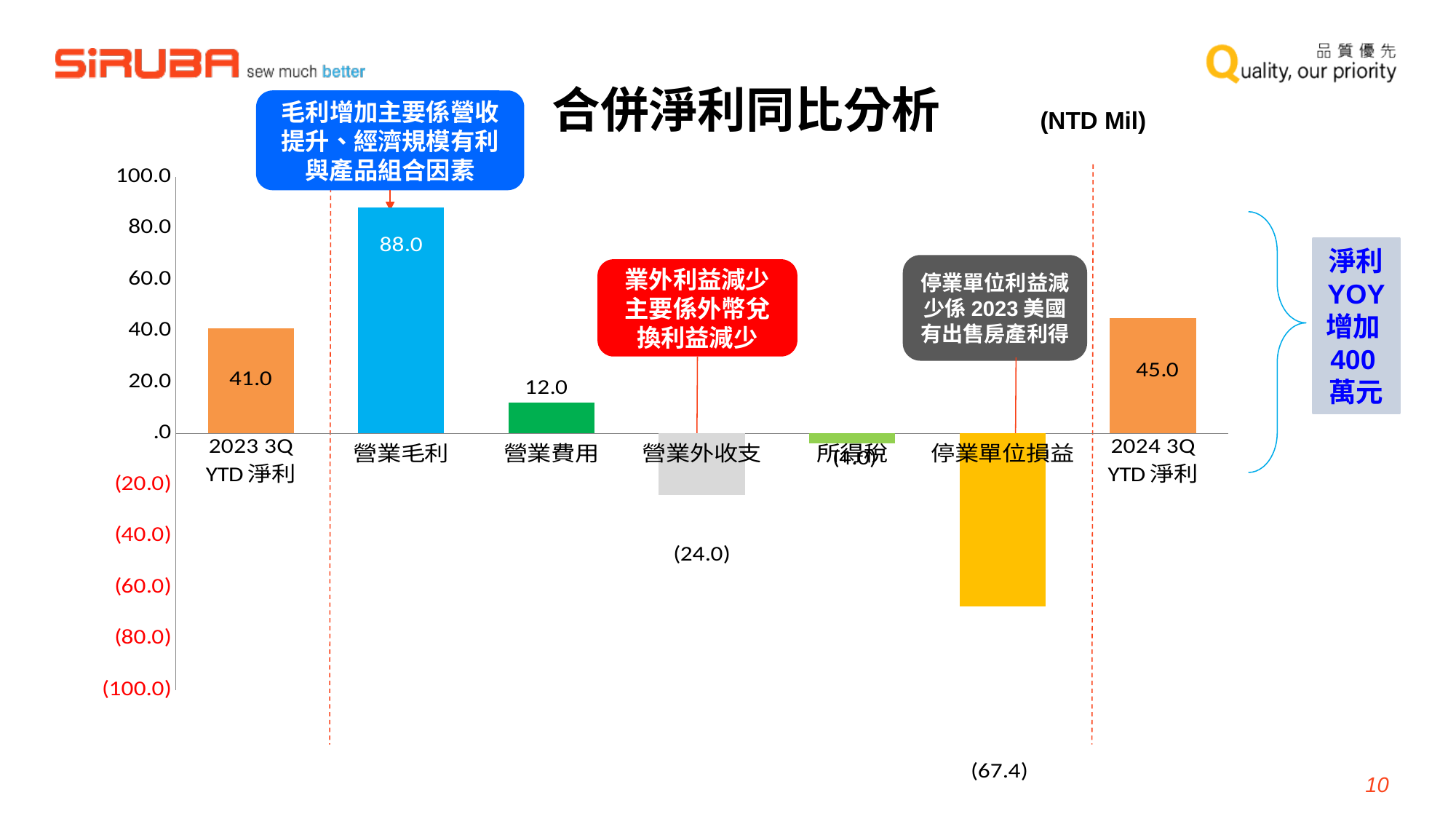
What is the value for 2023 3Q YTD 淨利? 41.0 What is the value for 停業單位損益? (67.4) Which category has the highest value? 營業毛利 What kind of chart is shown on the slide? Bar chart Which category has the lowest value? 停業單位損益 What is the value for 營業毛利? 88.0 What is the difference between the 2024 3Q YTD 淨利 and 2023 3Q YTD 淨利 values? 4.0 How many categories are shown on the x axis? 7 What is the value for 營業外收支? (24.0) What is the value for 營業費用? 12.0 What is the value for 2024 3Q YTD 淨利? 45.0 Which is larger, the value for 營業毛利 or the value for 營業費用? 營業毛利